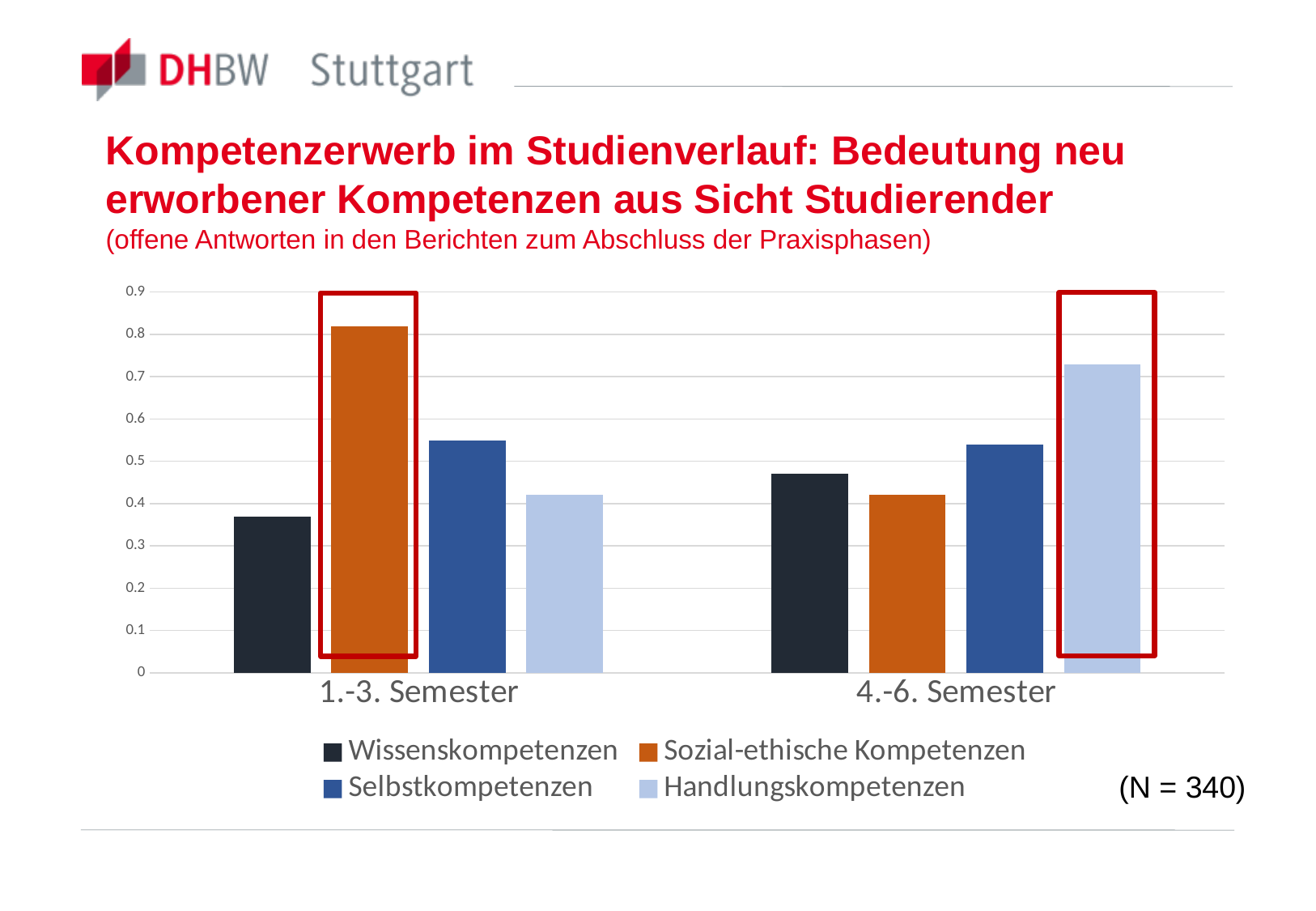
Is the value for Handlungskompetenzen in 4.-6. Semester greater or less than 0.7? greater Is the value for Sozial-ethische Kompetenzen in 1.-3. Semester greater or less than 0.8? greater Which competence has the highest value for 1.-3. Semester? Sozial-ethische Kompetenzen What kind of chart is shown on the slide? bar chart What sample size (N) is stated on the slide? N = 340 Which competence has the lowest value for 1.-3. Semester? Wissenskompetenzen How many semester groups are shown on the x axis? 2 Which is larger: Handlungskompetenzen in 1.-3. Semester or Handlungskompetenzen in 4.-6. Semester? 4.-6. Semester How many series does the legend list? 4 Which competence has the lowest value for 4.-6. Semester? Sozial-ethische Kompetenzen Which competence has the highest value for 4.-6. Semester? Handlungskompetenzen Is the value for Wissenskompetenzen in 1.-3. Semester greater or less than 0.4? less